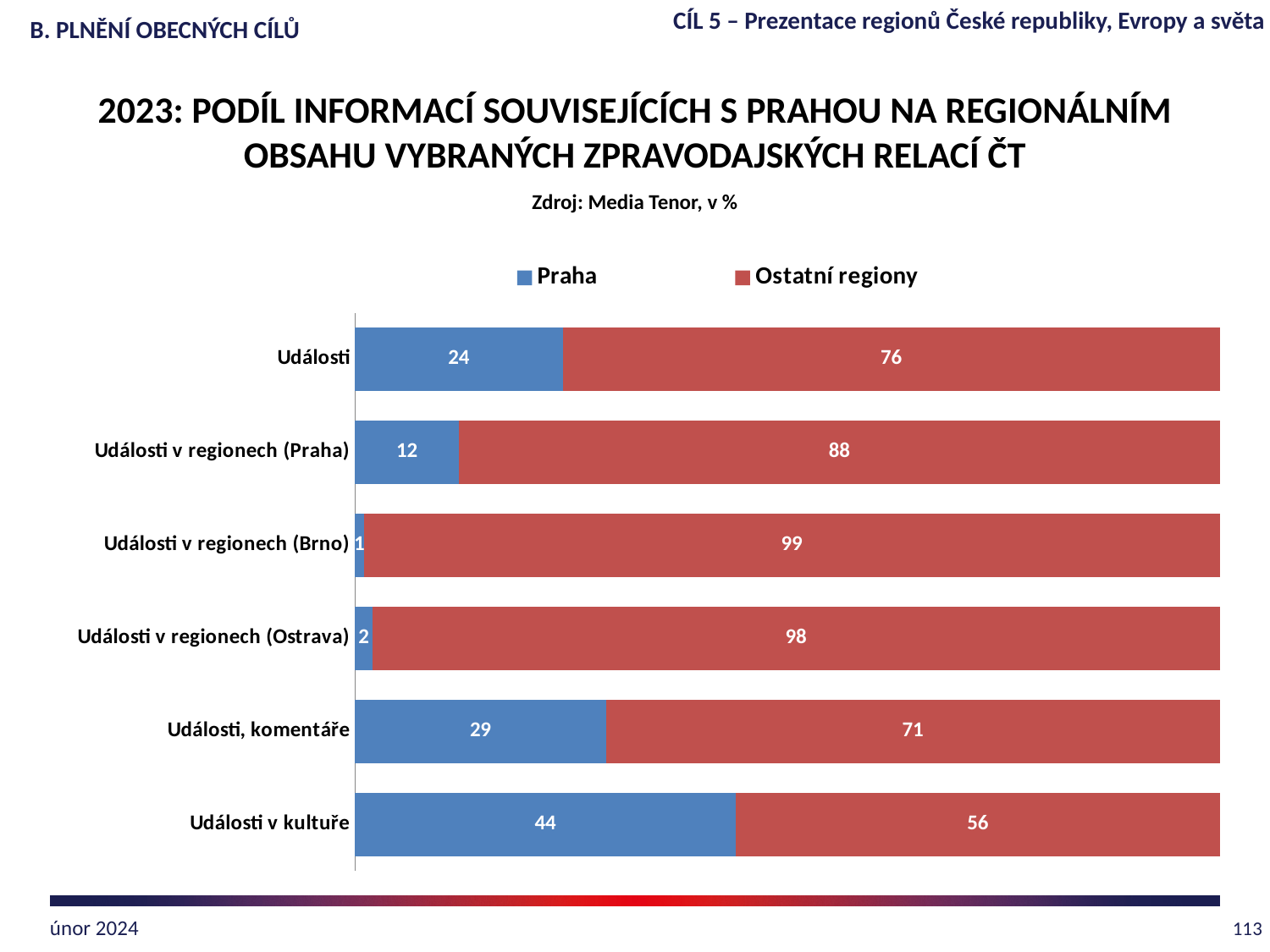
What is the value for Praha in the Události v kultuře category? 44 Which category has the highest value for Praha? Události v kultuře Which is larger in the Události v kultuře category: Praha or Ostatní regiony? Ostatní regiony Which colour represents the Praha series in the legend? Blue What is the total of the stacked bar for Události v regionech (Ostrava)? 100 What is the difference between the Ostatní regiony and Praha values in the Události, komentáře category? 42 How many series does the legend list? 2 What kind of chart is shown on the slide? Stacked bar chart Which category has the lowest value for Praha? Události v regionech (Brno) What is the value for Ostatní regiony in the Události v regionech (Praha) category? 88 How many categories are shown on the chart? 6 What is the value for Praha in the Události category? 24